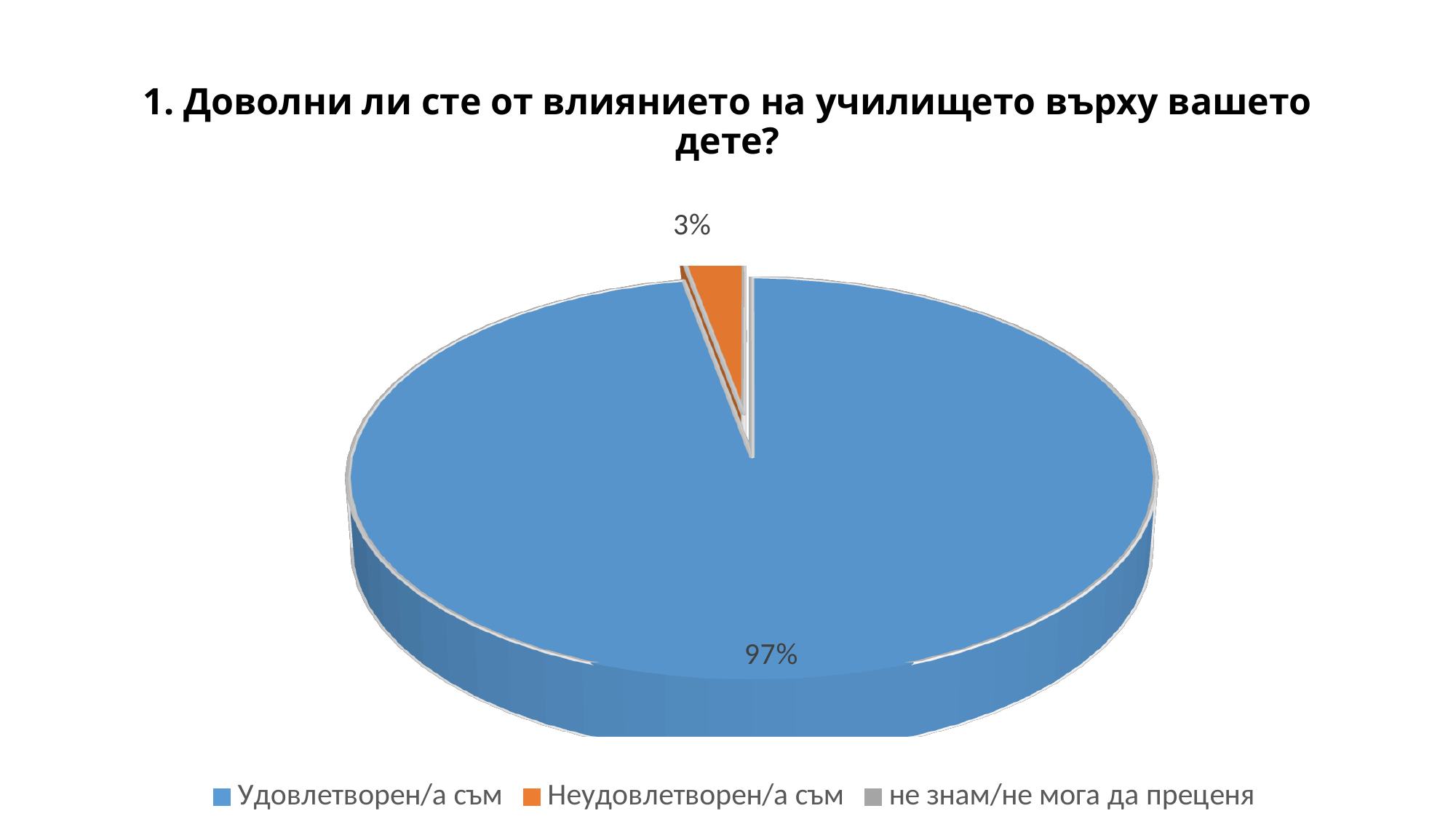
What percentage of respondents answered "Удовлетворен/а съм"? 97% By how many percentage points does the "Удовлетворен/а съм" share exceed the "Неудовлетворен/а съм" share? 94 percentage points What percentage of respondents answered "Неудовлетворен/а съм"? 3% What is the title of the chart? 1. Доволни ли сте от влиянието на училището върху вашето дете? Which is larger, the share for "Удовлетворен/а съм" or the share for "Неудовлетворен/а съм"? Удовлетворен/а съм How many entries does the legend list? 3 What kind of chart is shown on the slide? Pie chart What share of the pie does the blue slice represent? 97% Which response has the largest share of the pie? Удовлетворен/а съм Which colour represents "Неудовлетворен/а съм" in the chart? Orange